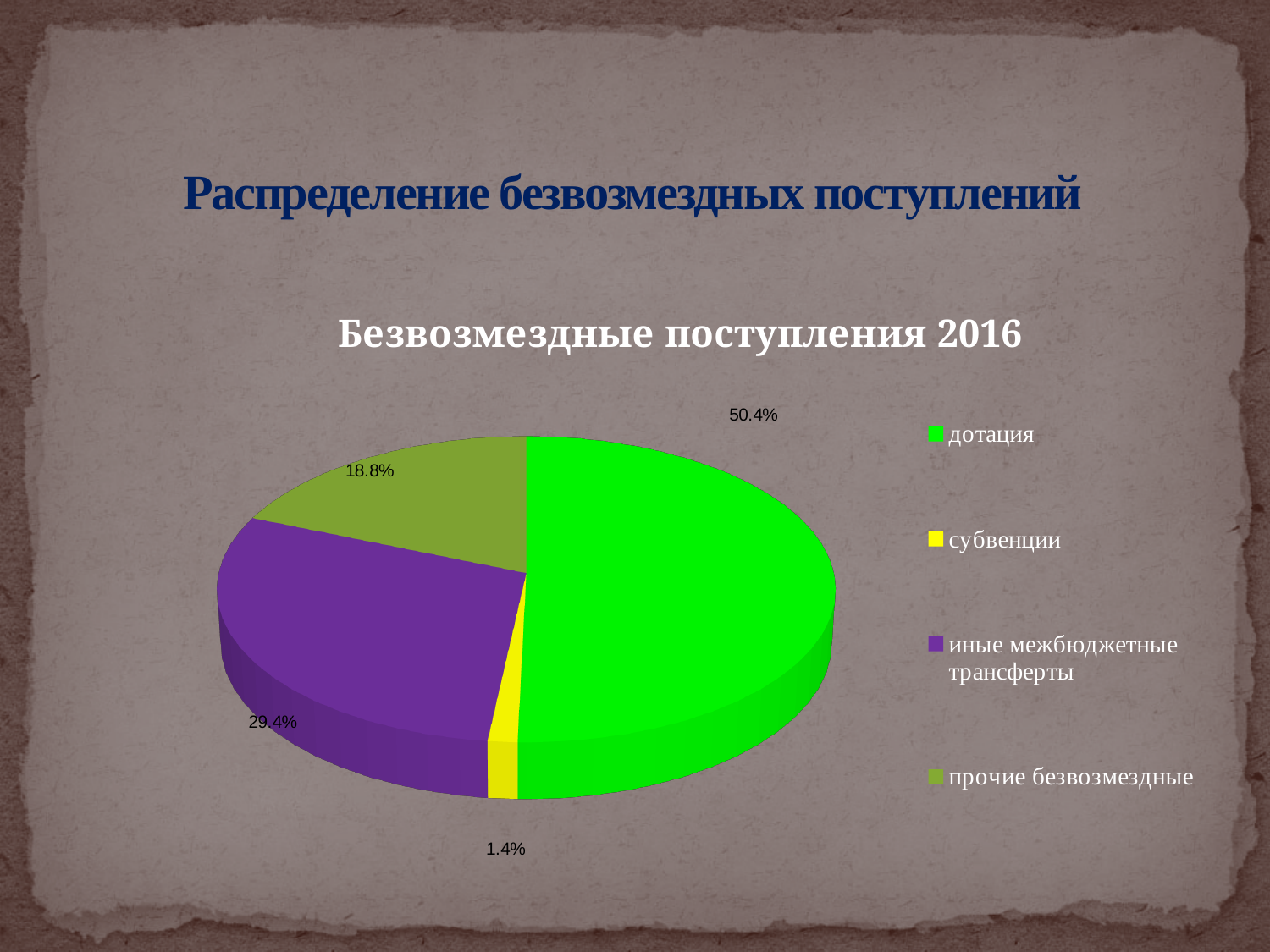
What share of the pie does иные межбюджетные трансферты have? 29.4% What is the difference in percentage points between дотация and иные межбюджетные трансферты? 21.0% What kind of chart is shown on the slide? pie chart How many categories does the pie chart show? 4 What is the difference in percentage points between иные межбюджетные трансферты and прочие безвозмездные? 10.6% What is the title of the chart? Безвозмездные поступления 2016 Which category has the smallest slice of the pie? субвенции What share of the pie does субвенции have? 1.4% What share of the pie does прочие безвозмездные have? 18.8% Which category has the largest slice of the pie? дотация Which is larger, the share for прочие безвозмездные or the share for субвенции? прочие безвозмездные